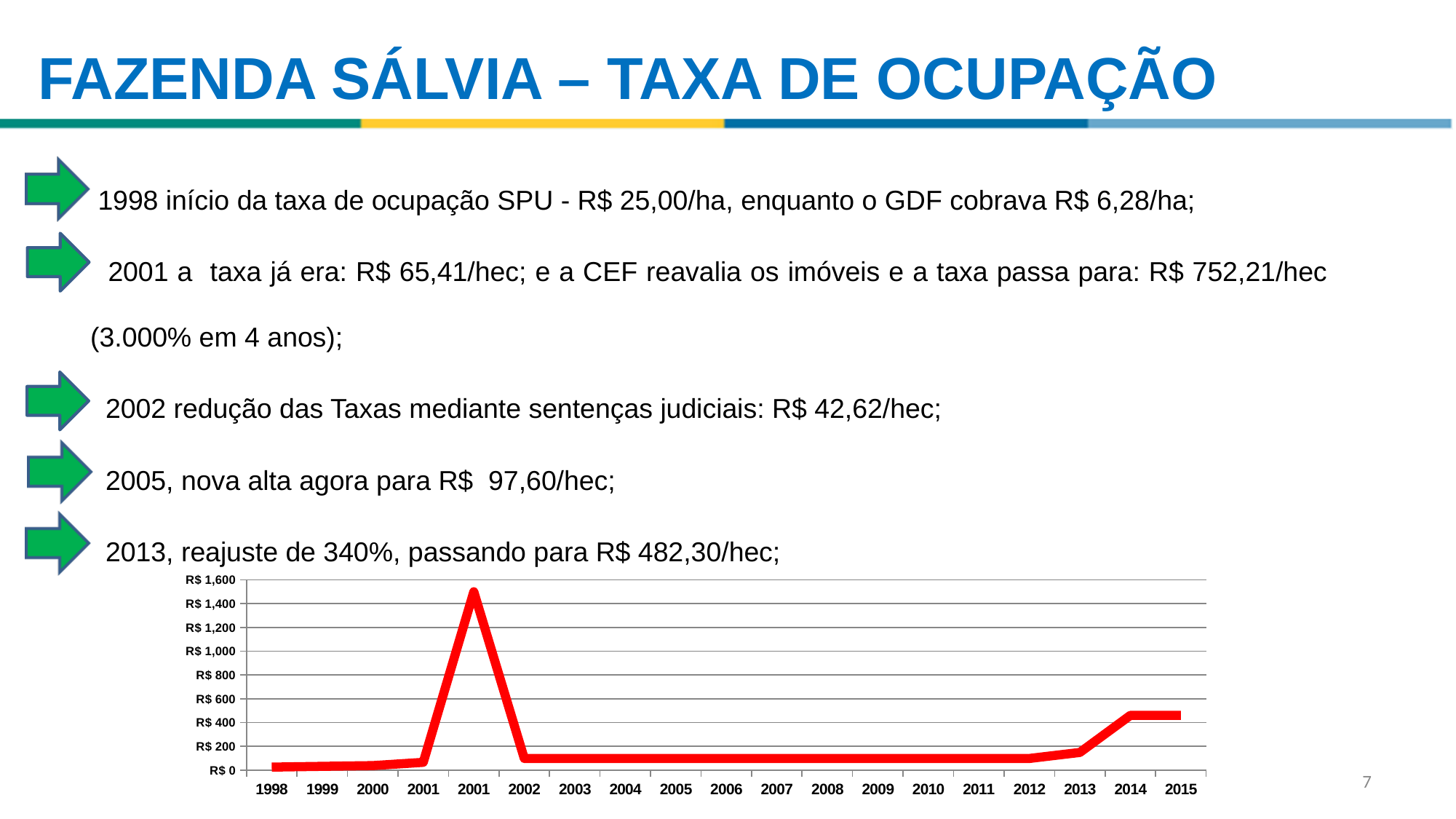
Does the line rise or fall between 2013 and 2014? rise What colour is the line in the chart? red How many year labels are shown along the x axis of the chart? 19 What is the highest tick label on the y axis of the chart? R$ 1,600 Which year has the larger value, 2012 or 2014? 2014 Is the value for 2012 greater or less than R$ 200? less What kind of chart is shown at the bottom of the slide? line chart Is the value for 2013 greater or less than R$ 200? less Is the peak value of the line in 2001 greater or less than R$ 1,400? greater In which year does the line reach its highest value? 2001 Does the line rise or fall between the 2001 peak and 2002? fall